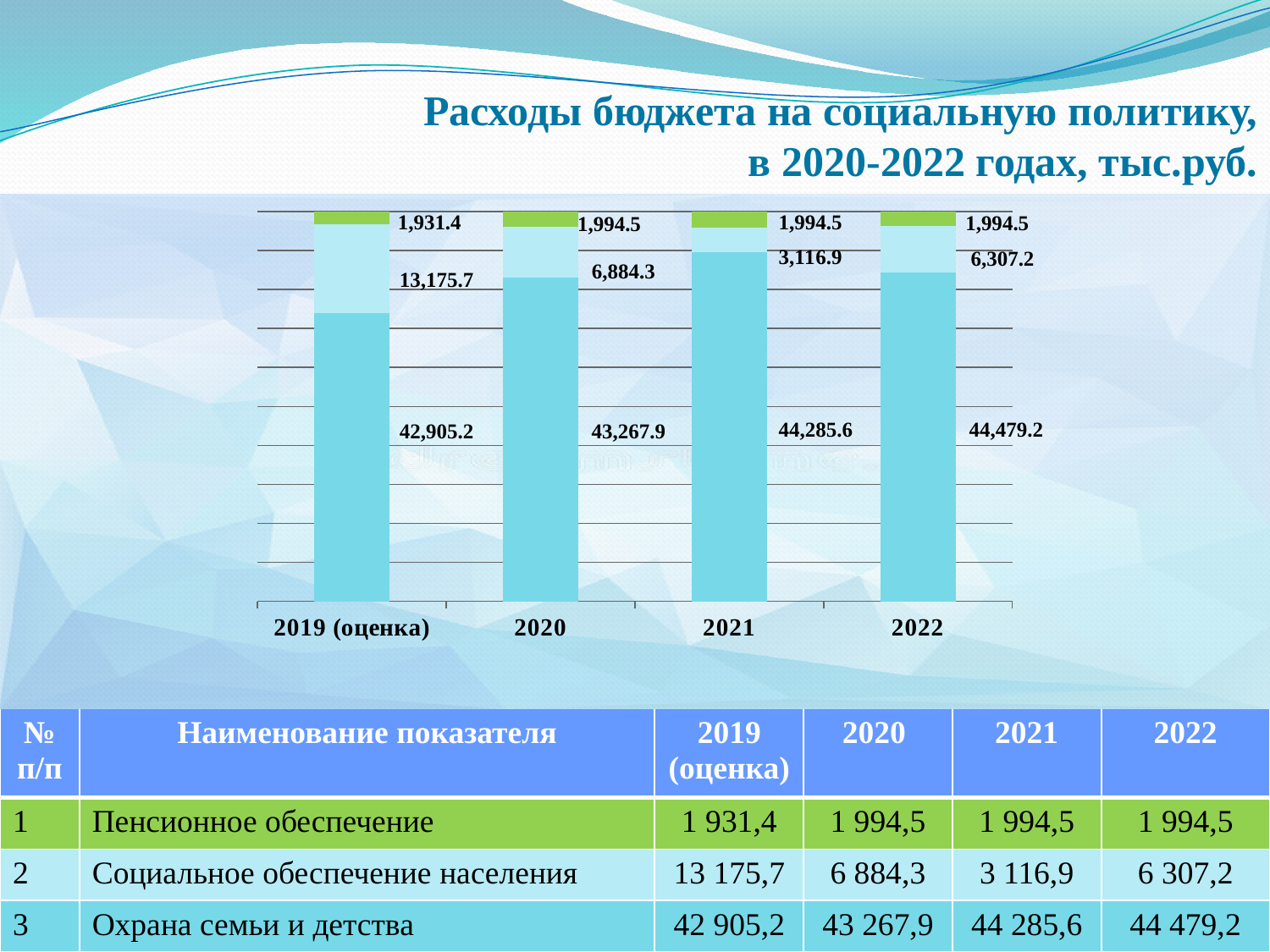
Does the value of the bottom segment rise or fall from 2019 (оценка) to 2022? rise Which year has the highest value for the bottom segment of the bar? 2022 What is the value of the bottom (largest) segment of the bar for 2021? 44,285.6 What is the value of the middle segment of the bar for 2019 (оценка)? 13,175.7 How many years (categories) are shown on the x axis of the chart? 4 What is the difference between the bottom segment values for 2022 and 2019 (оценка)? 1,574.0 What kind of chart is shown on the slide? stacked bar chart Is the middle segment value for 2020 larger or smaller than that for 2022? larger What is the total of the stacked bar for 2021? 49,397.0 What is the value of the top (green) segment of the bar for 2020? 1,994.5 What is the value of the middle segment of the bar for 2022? 6,307.2 Which year has the lowest value for the middle segment of the bar? 2021